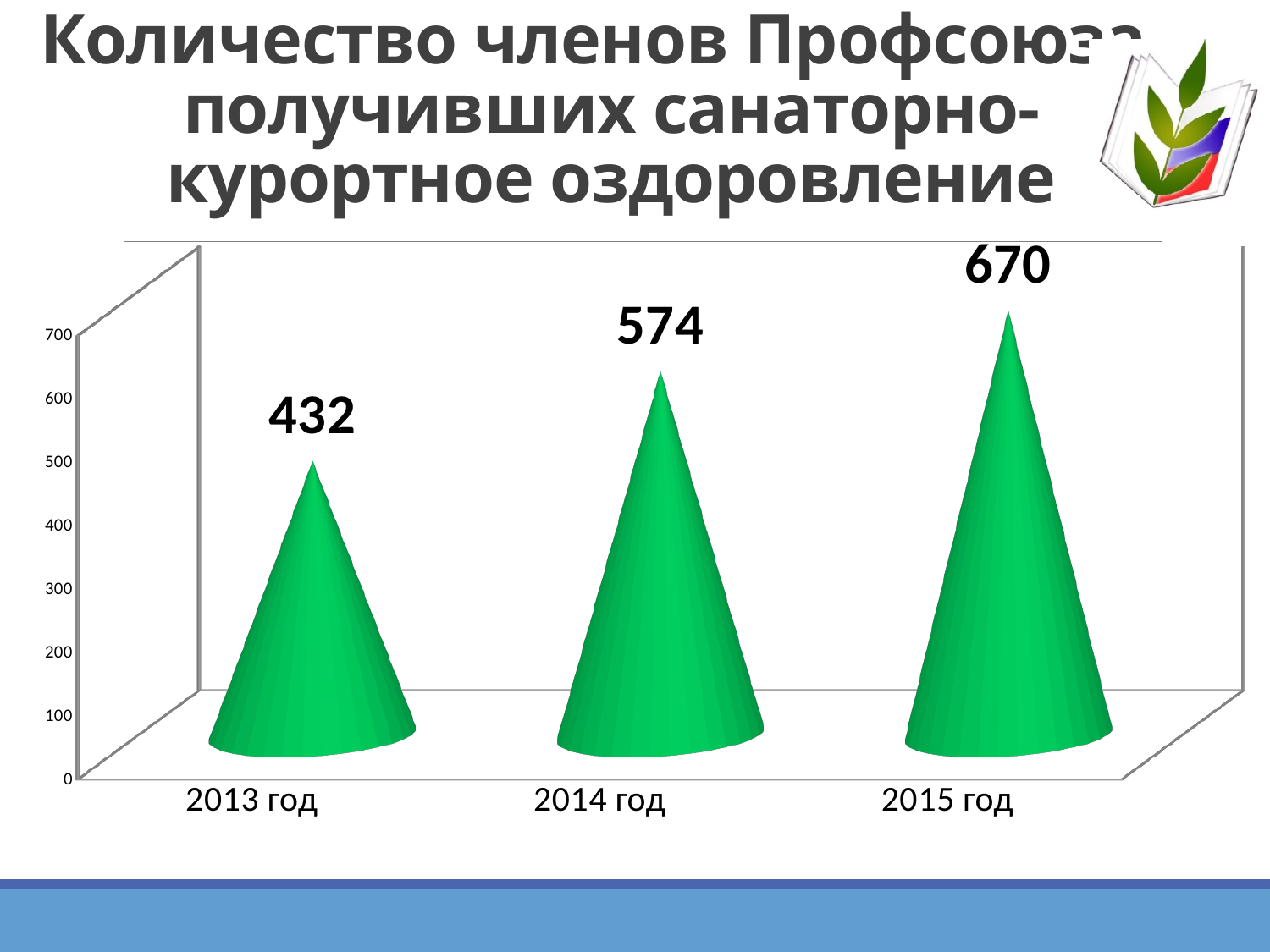
Which year has the highest value? 2015 год Which year has the lowest value? 2013 год What is the difference between the values for 2015 год and 2013 год? 238 What is the difference between the values for 2014 год and 2013 год? 142 Which is larger, the value for 2014 год or the value for 2013 год? 2014 год Is the value for 2015 год greater or less than 600? greater What is the value for 2014 год? 574 What is the value for 2015 год? 670 What is the value for 2013 год? 432 Do the values rise or fall from 2013 год to 2015 год? rise How many categories are shown on the x axis? 3 What colour are the bars in the chart? green